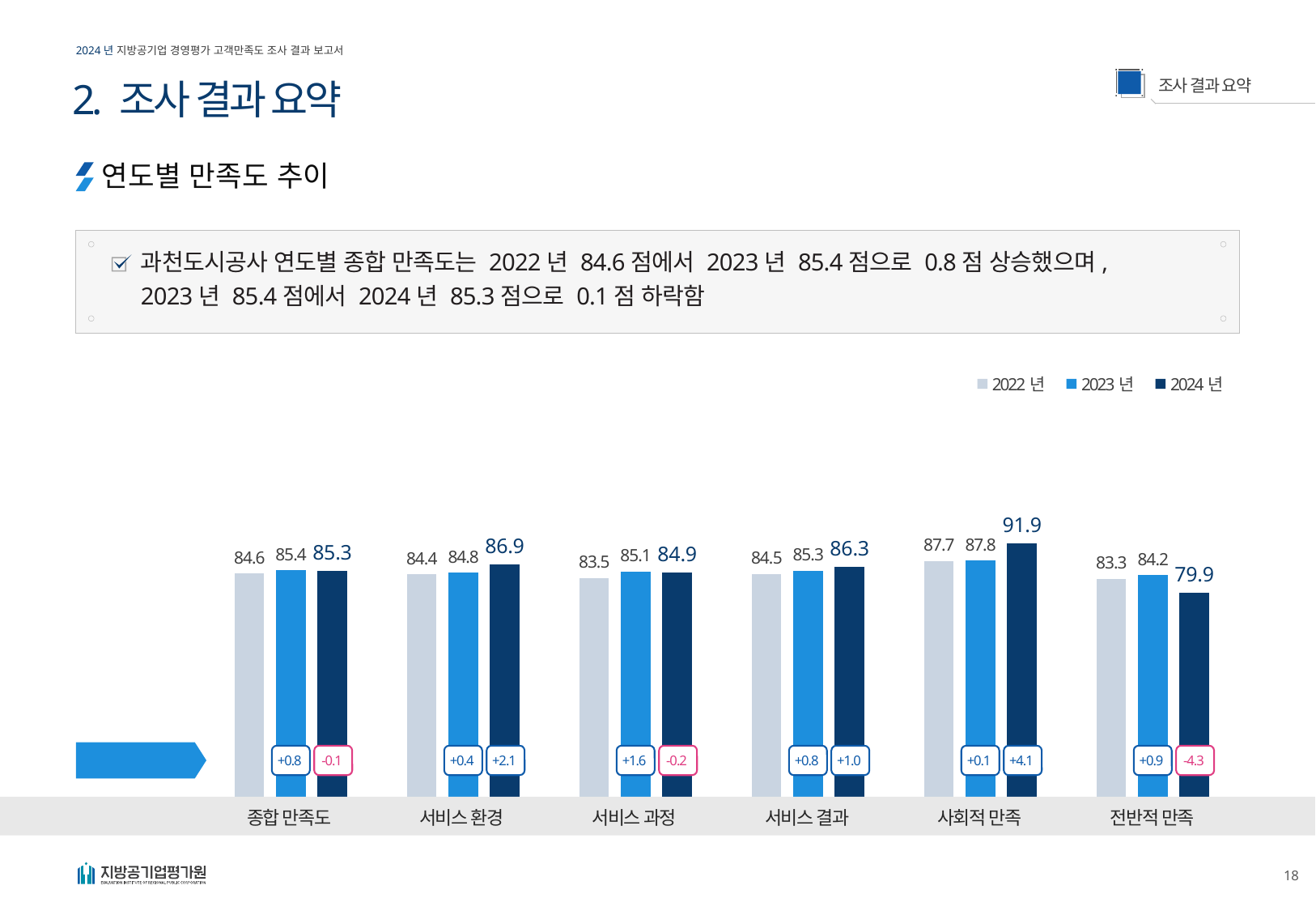
What is the 2024년 value for 사회적 만족? 91.9 What kind of chart is shown on the slide? bar chart How many series does the legend list? 3 Which category has the lowest 2022년 value? 전반적 만족 What colour are the 2024년 bars? dark navy blue What is the 2022년 value for 서비스 과정? 83.5 Which category has the lowest 2024년 value? 전반적 만족 How many categories are shown on the x axis? 6 What is the difference between the 2024년 and 2022년 values for 서비스 환경? 2.5 What is the 2023년 value for 전반적 만족? 84.2 Which category has the highest 2024년 value? 사회적 만족 Which is larger for 전반적 만족: the 2023년 value or the 2024년 value? 2023년